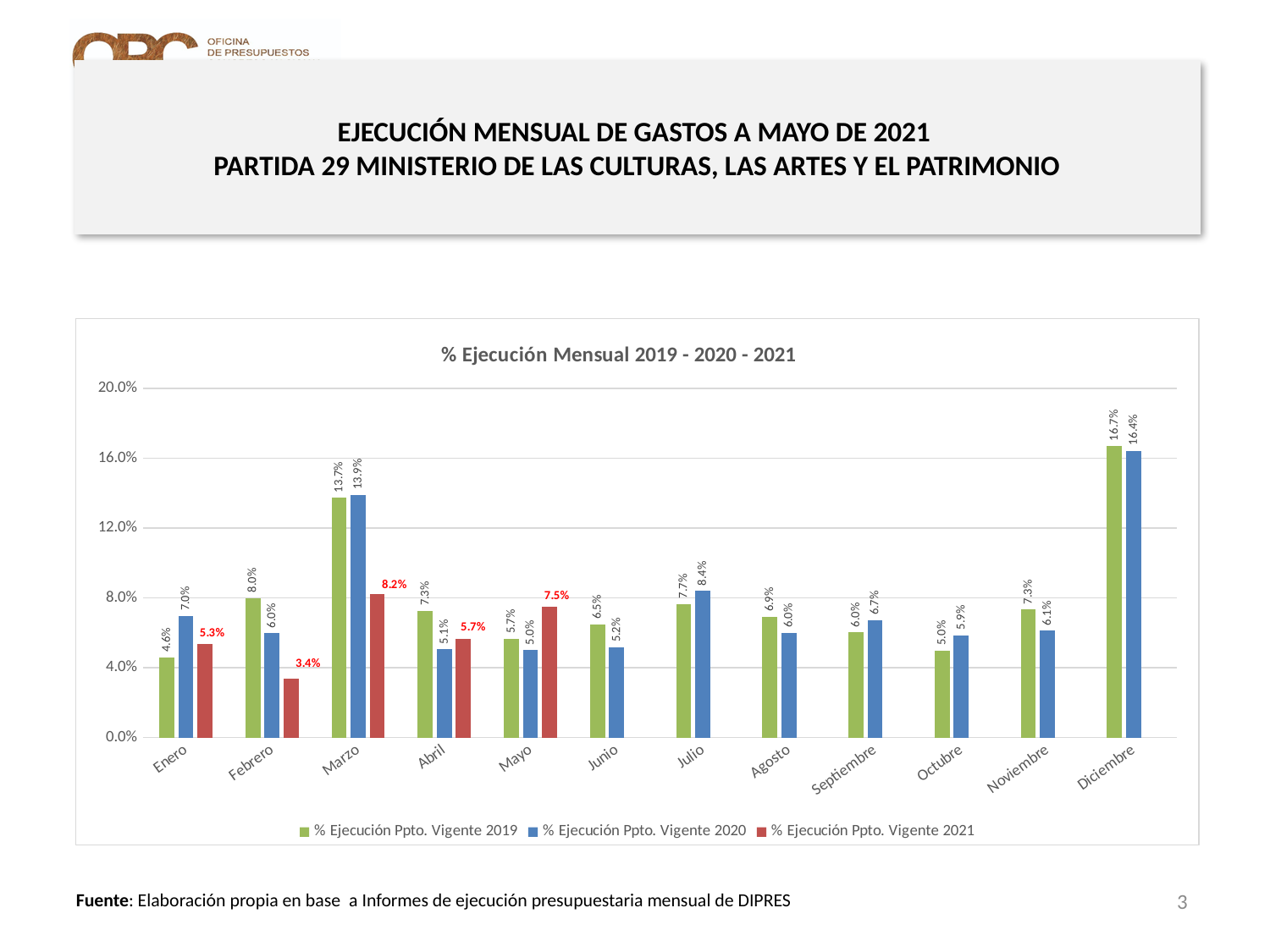
Which month has the highest value for % Ejecución Ppto. Vigente 2020? Diciembre Is the value for % Ejecución Ppto. Vigente 2019 in Marzo greater or less than 12.0%? greater How many series does the legend list? 3 Which month has the lowest value for % Ejecución Ppto. Vigente 2021? Febrero What is the value for % Ejecución Ppto. Vigente 2021 in Marzo? 8.2% In Mayo, which series has the larger value: % Ejecución Ppto. Vigente 2019 or % Ejecución Ppto. Vigente 2021? % Ejecución Ppto. Vigente 2021 How many months are shown on the x axis? 12 What is the title of the chart? % Ejecución Mensual 2019 - 2020 - 2021 What is the value for % Ejecución Ppto. Vigente 2020 in Julio? 8.4% What kind of chart is shown on the slide? Bar chart What is the value for % Ejecución Ppto. Vigente 2019 in Diciembre? 16.7% What is the difference between the 2019 and 2020 values in Enero? 2.4%